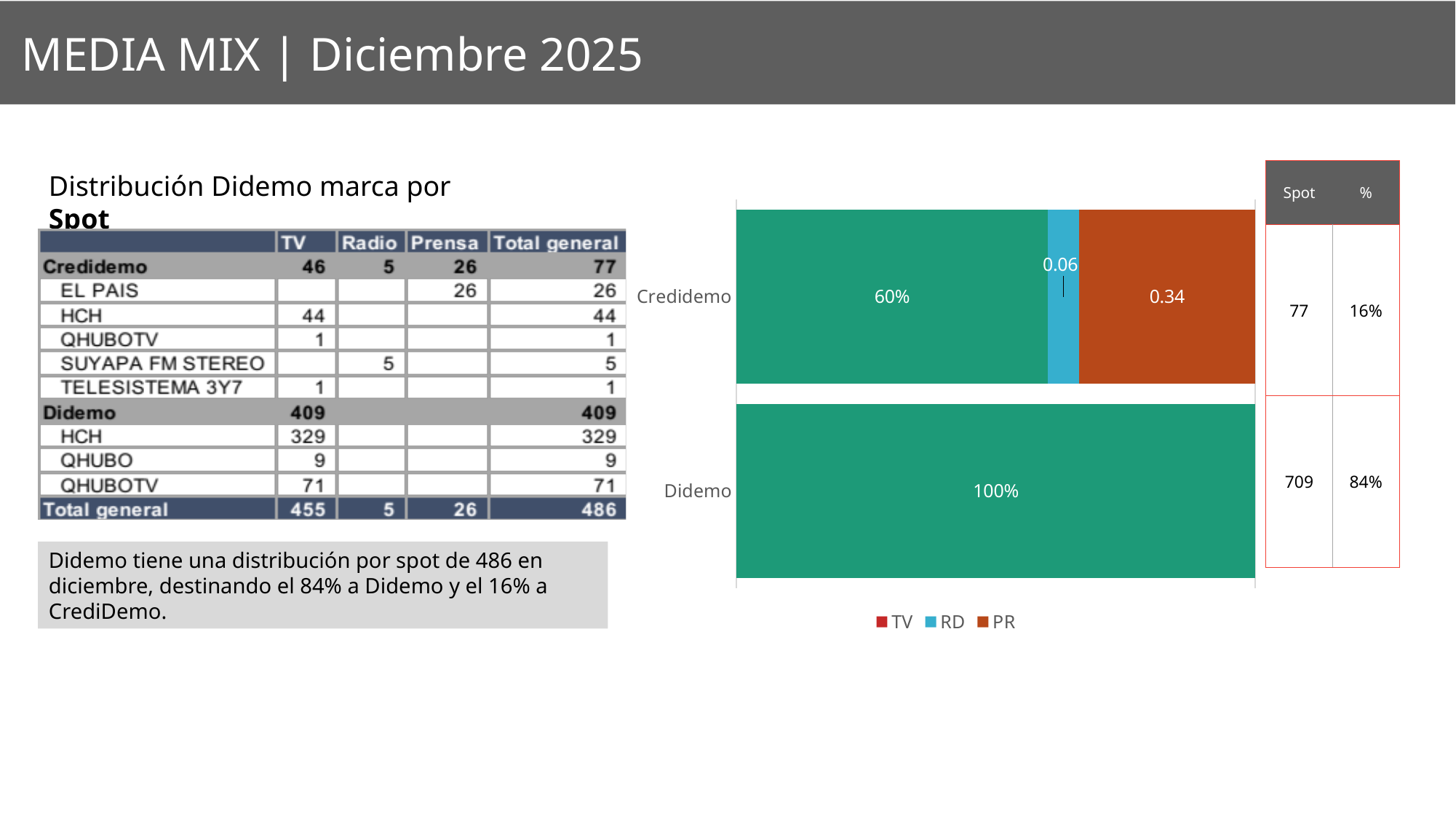
What is the TV value for Didemo in the bar chart? 100% How many categories does the bar chart show? 2 For Credidemo, which segment is larger, RD or PR? PR What is the TV value for Credidemo in the bar chart? 60% What is the PR value for Credidemo in the bar chart? 0.34 What are the series names listed in the chart legend? TV, RD, PR What is the RD value for Credidemo in the bar chart? 0.06 Which category has the larger TV share in the bar chart, Credidemo or Didemo? Didemo Which category's bar is made up entirely of a single series? Didemo What kind of chart is shown on the slide? stacked bar chart How many series does the chart legend list? 3